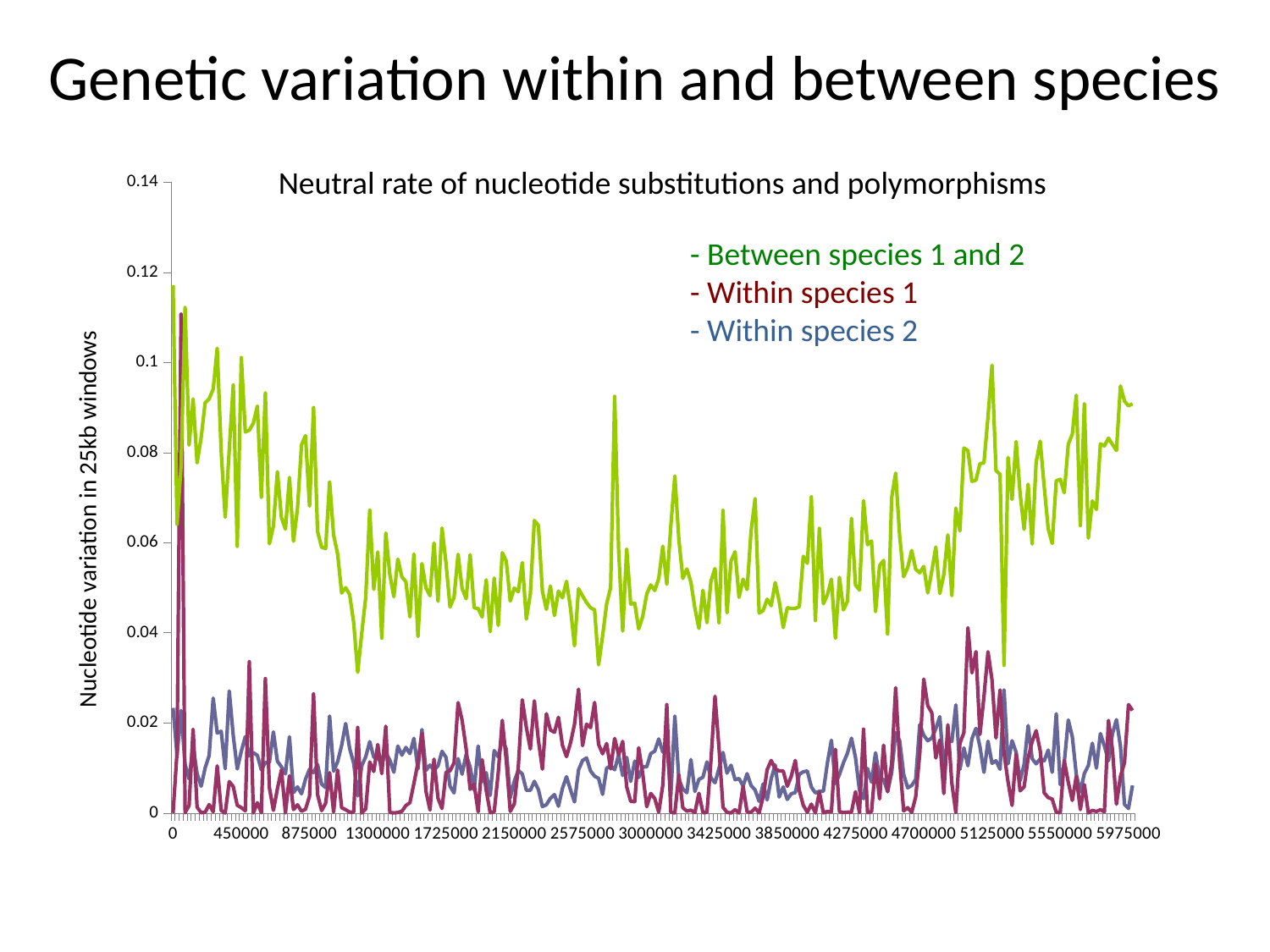
What kind of chart is shown on the slide? line chart Which series has higher values overall, Between species 1 and 2 or Within species 2? Between species 1 and 2 What is the label of the y axis? Nucleotide variation in 25kb windows Is the highest value of the Within species 2 series greater or less than 0.04? less How many series does the legend list? 3 Does the Between species 1 and 2 series generally rise or fall between x = 0 and x = 1300000? fall Which series has the highest values across most of the x axis? Between species 1 and 2 What is the title of the chart? Neutral rate of nucleotide substitutions and polymorphisms Is the first value of the Between species 1 and 2 series (at x = 0) greater or less than 0.1? greater Is the highest value of the Within species 1 series greater or less than 0.12? less What is the highest value labelled on the y axis? 0.14